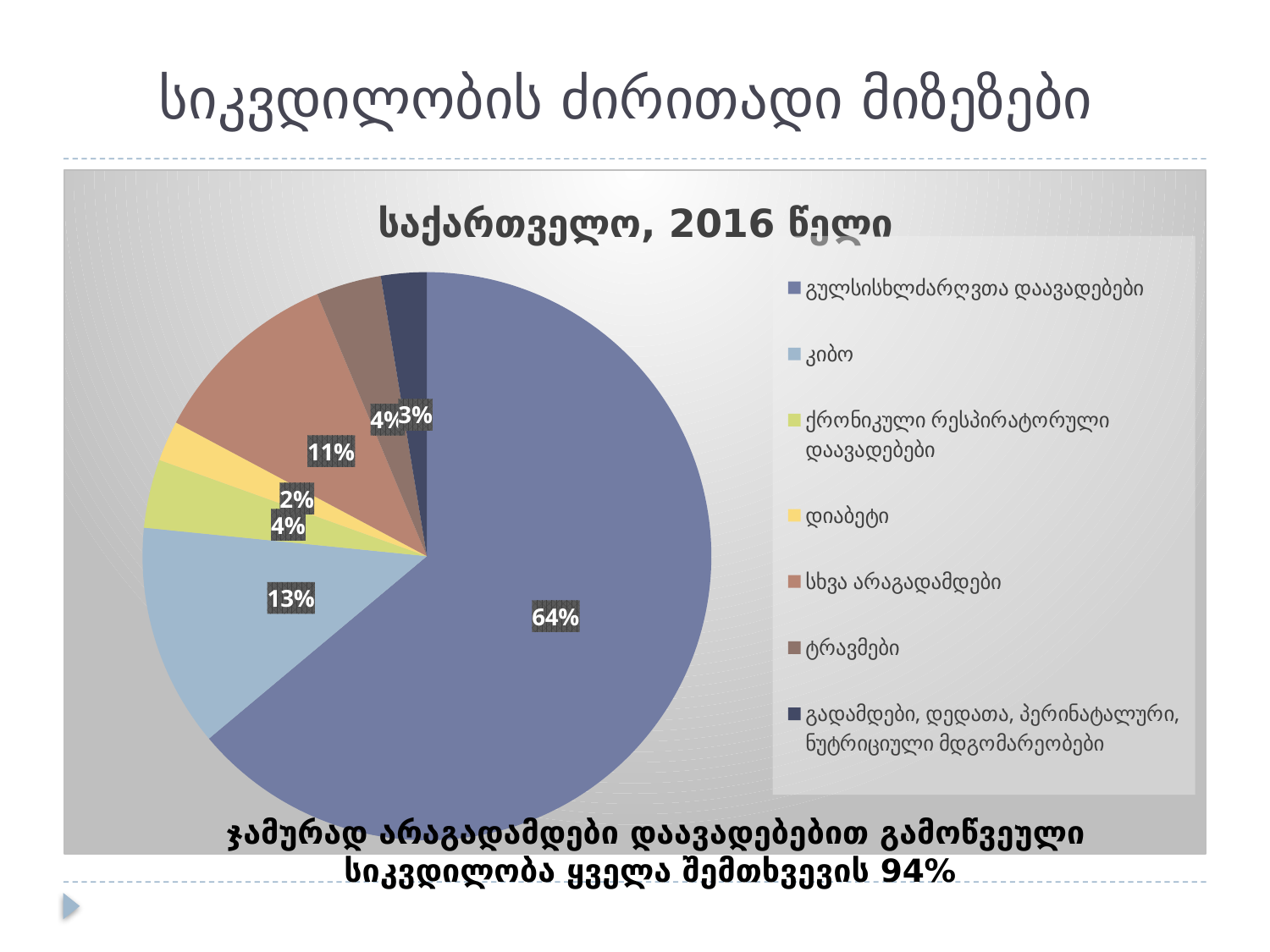
What share of the pie is კიბო? 13% Which is larger, the slice for კიბო or the slice for სხვა არაგადამდები? კიბო What share of the pie is გადამდები, დედათა, პერინატალური, ნუტრიციული მდგომარეობები? 3% How many categories does the legend of the pie chart list? 7 What kind of chart is shown on the slide? pie chart What share of the pie is დიაბეტი? 2% Which category has the largest slice of the pie? გულსისხლძარღვთა დაავადებები What is the title of the chart? საქართველო, 2016 წელი What is the difference in percentage points between გულსისხლძარღვთა დაავადებები and კიბო? 51 Which category has the smallest slice of the pie? დიაბეტი